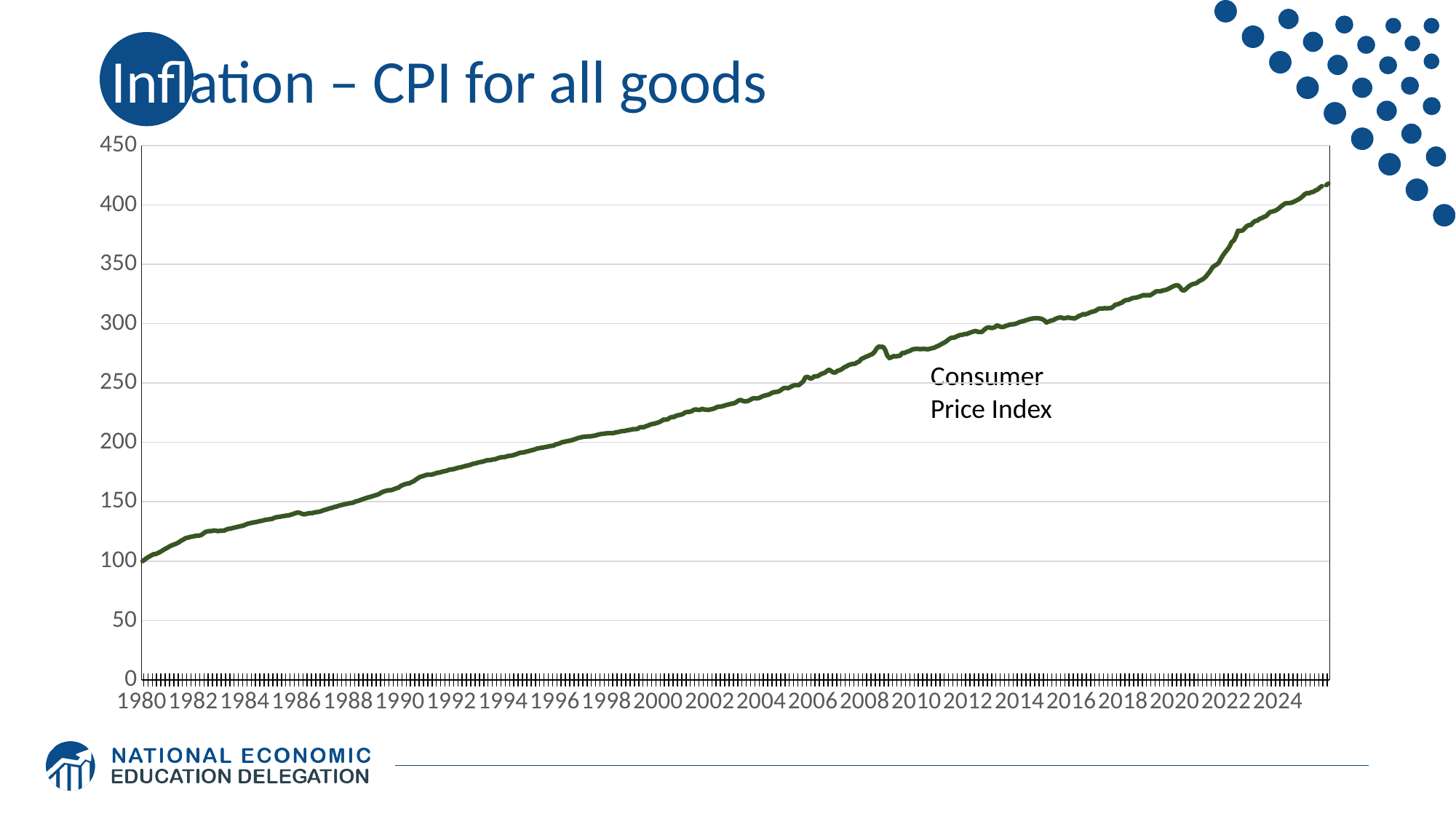
Is the value of the Consumer Price Index in 2010 greater or less than 250? greater Is the value of the Consumer Price Index in 2022 greater or less than 350? greater Is the value of the Consumer Price Index in 2000 greater or less than 250? less What is the title of the slide's chart? Inflation – CPI for all goods What is the highest value shown on the vertical axis? 450 In which year shown on the x axis is the Consumer Price Index lowest? 1980 Is the Consumer Price Index higher in 2020 or in 1996? 2020 What series label is printed next to the line on the chart? Consumer Price Index Does the Consumer Price Index generally rise or fall from 1980 to 2024? rise What kind of chart is shown on the slide? line chart